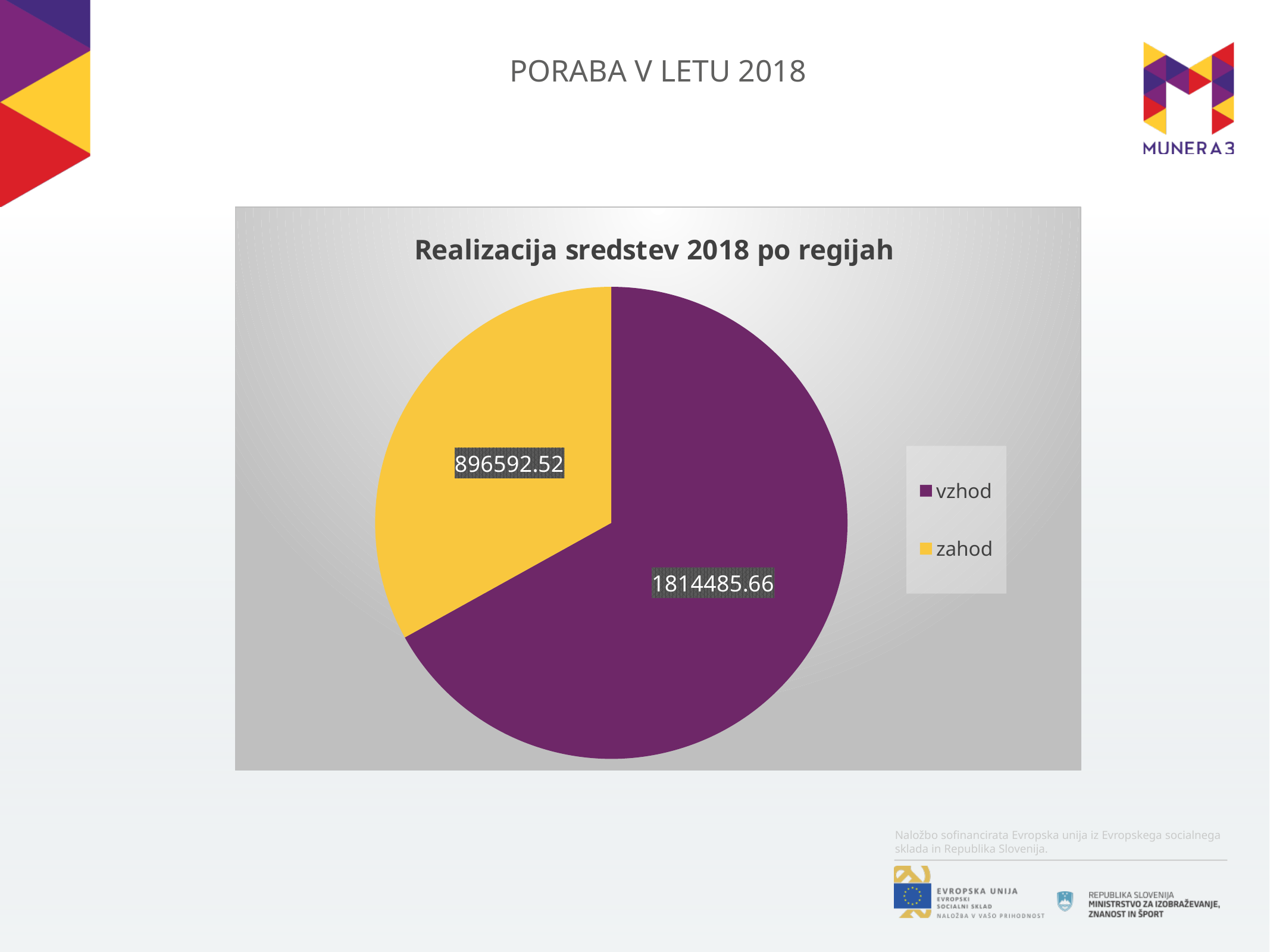
Which region has the smallest slice of the pie? zahod Which region has the largest slice of the pie? vzhod What kind of chart is shown on the slide? pie chart What is the title of the chart? Realizacija sredstev 2018 po regijah What is the total of the two slices in the pie chart? 2711078.18 What is the value for vzhod? 1814485.66 Which is larger, the value for vzhod or the value for zahod? vzhod How many slices does the pie chart have? 2 What is the value for zahod? 896592.52 What is the difference between the value for vzhod and the value for zahod? 917893.14 What colour is the slice for zahod? yellow